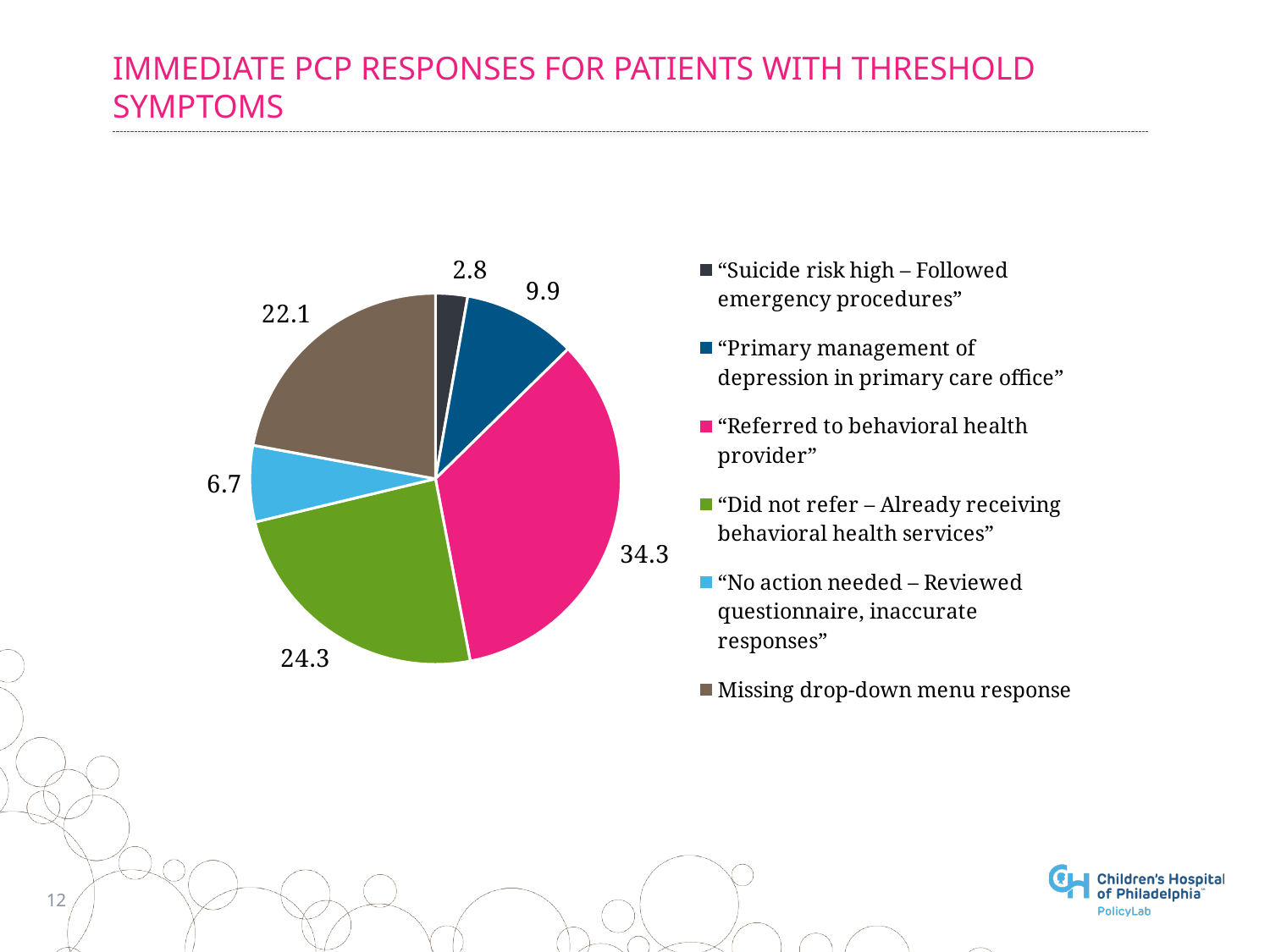
What type of chart is shown on the slide? Pie chart How many slices does the pie chart have? 6 What is the value for "Suicide risk high – Followed emergency procedures"? 2.8 What is the value for "Referred to behavioral health provider"? 34.3 What is the value for "Missing drop-down menu response"? 22.1 What colour is the slice for "Did not refer – Already receiving behavioral health services"? Green Which category has the largest slice of the pie? "Referred to behavioral health provider" Which is larger: the value for "Primary management of depression in primary care office" or the value for "No action needed – Reviewed questionnaire, inaccurate responses"? "Primary management of depression in primary care office" What is the value for "No action needed – Reviewed questionnaire, inaccurate responses"? 6.7 Which category has the smallest slice of the pie? "Suicide risk high – Followed emergency procedures" How many entries does the legend list? 6 What is the difference between the values for "Referred to behavioral health provider" and "Did not refer – Already receiving behavioral health services"? 10.0